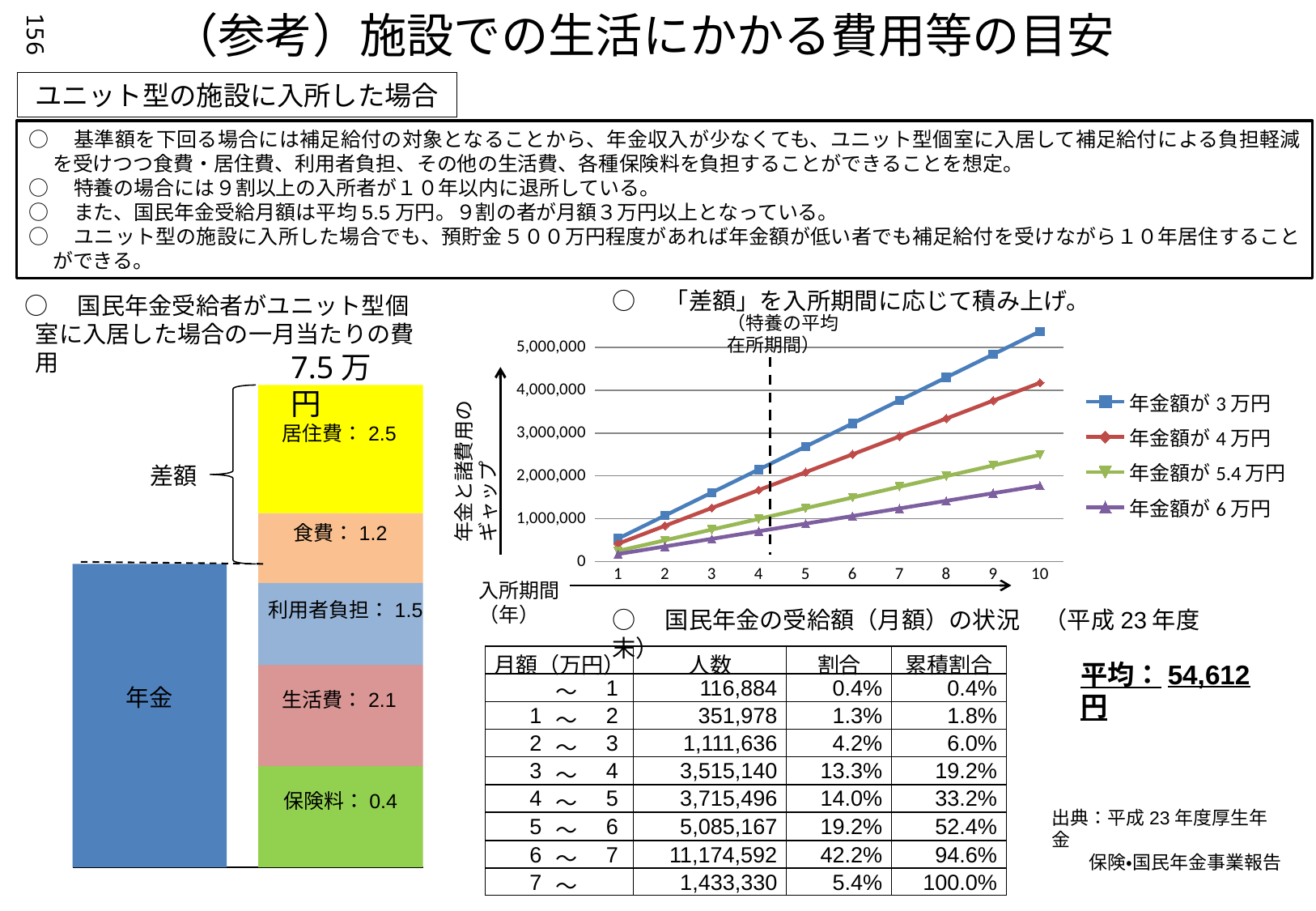
On the left stacked bar chart, which cost segment is the smallest? 保険料 On the left stacked bar chart, what is the value for 居住費? 2.5 On the left stacked bar chart, what is the difference between 生活費 and 食費? 0.9 On the right line chart, do the values rise or fall as the 入所期間 increases? rise On the left stacked bar chart, how many cost segments make up the stacked bar? 5 On the left stacked bar chart, what is the value for 保険料? 0.4 On the left stacked bar chart, which is larger, 利用者負担 or 食費? 利用者負担 On the left stacked bar chart, what is the total of the stacked cost bar? 7.5万円 On the right line chart, how many series does the legend list? 4 On the left stacked bar chart, which cost segment is the largest? 居住費 On the right line chart, is the value for 年金額が6万円 at year 10 greater or less than 2,000,000? less On the right line chart, is the value for 年金額が3万円 at year 10 greater or less than 5,000,000? greater